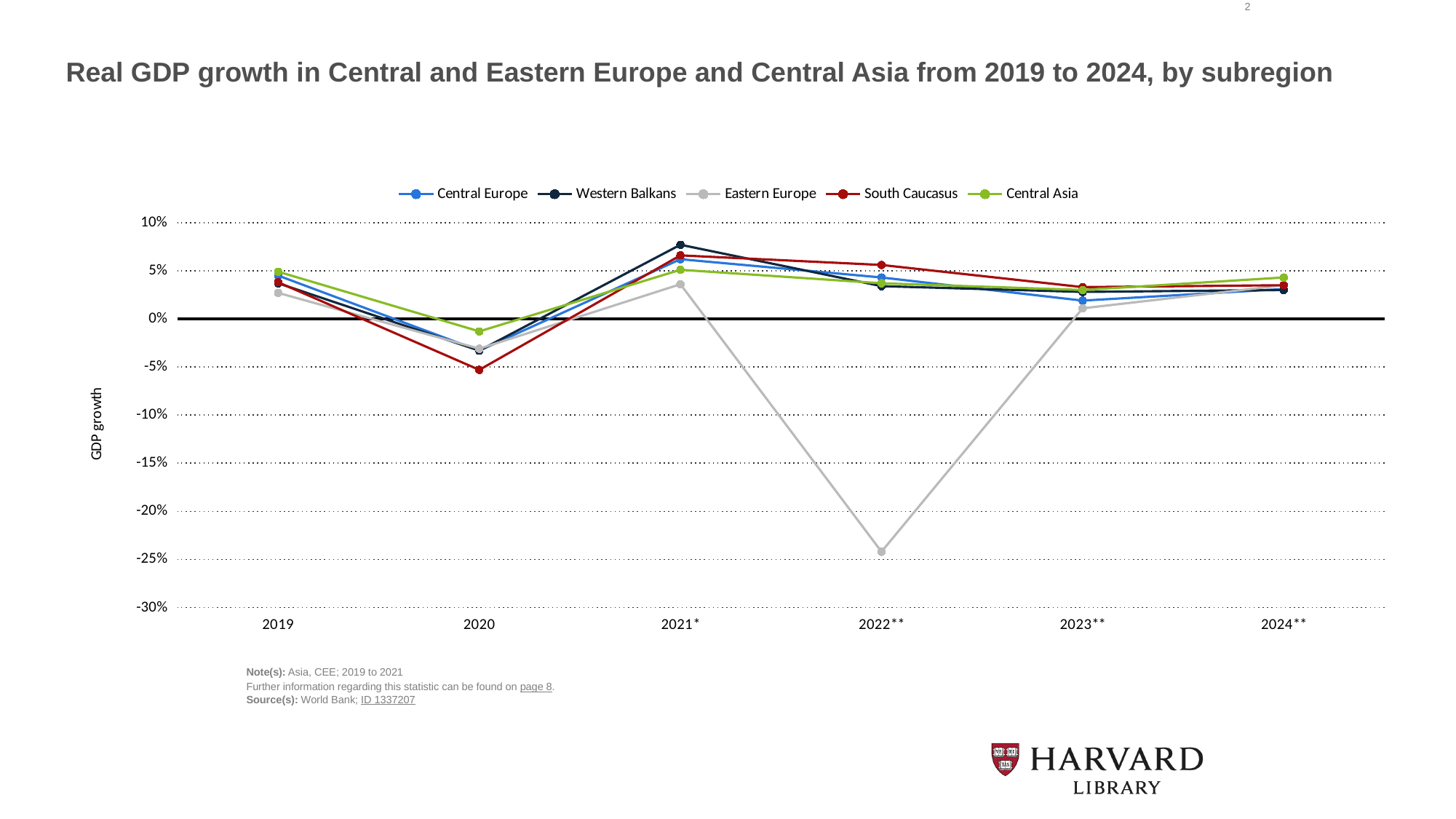
What kind of chart is shown on the slide? Line chart What is the label on the vertical axis? GDP growth How many years are shown along the x axis? 6 Does the Eastern Europe line rise or fall from 2021* to 2022**? Fall Which subregion has the highest GDP growth in 2021*? Western Balkans Which subregion has the lowest GDP growth in 2022**? Eastern Europe Which subregion has the lowest GDP growth in 2020? South Caucasus Is the value for Western Balkans in 2021* greater or less than 5%? greater Is the value for Eastern Europe in 2022** greater or less than -20%? less Which subregion has the highest GDP growth in 2022**? South Caucasus How many series does the legend list? 5 In 2020, which is higher: Central Asia or South Caucasus? Central Asia